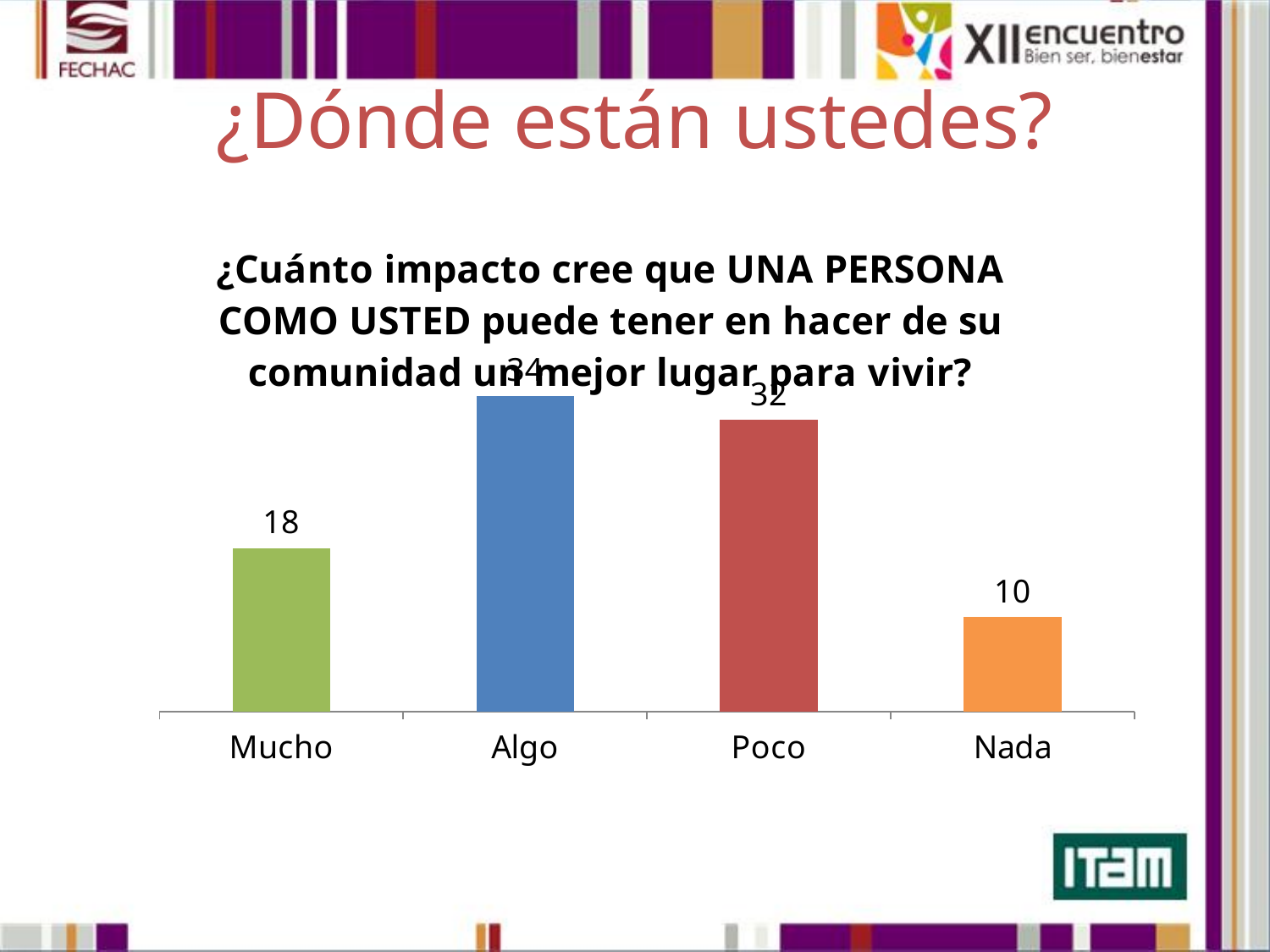
Which category has the highest value? Algo How many categories are shown on the x axis? 4 Which is larger, the value for Mucho or the value for Poco? Poco What is the difference between the values for Mucho and Nada? 8 What is the value for Algo? 34 What is the value for Nada? 10 What colour is the bar for Nada? orange What type of chart is shown on the slide? bar chart What is the value for Mucho? 18 What is the value for Poco? 32 Which category has the lowest value? Nada What is the difference between the values for Poco and Mucho? 14